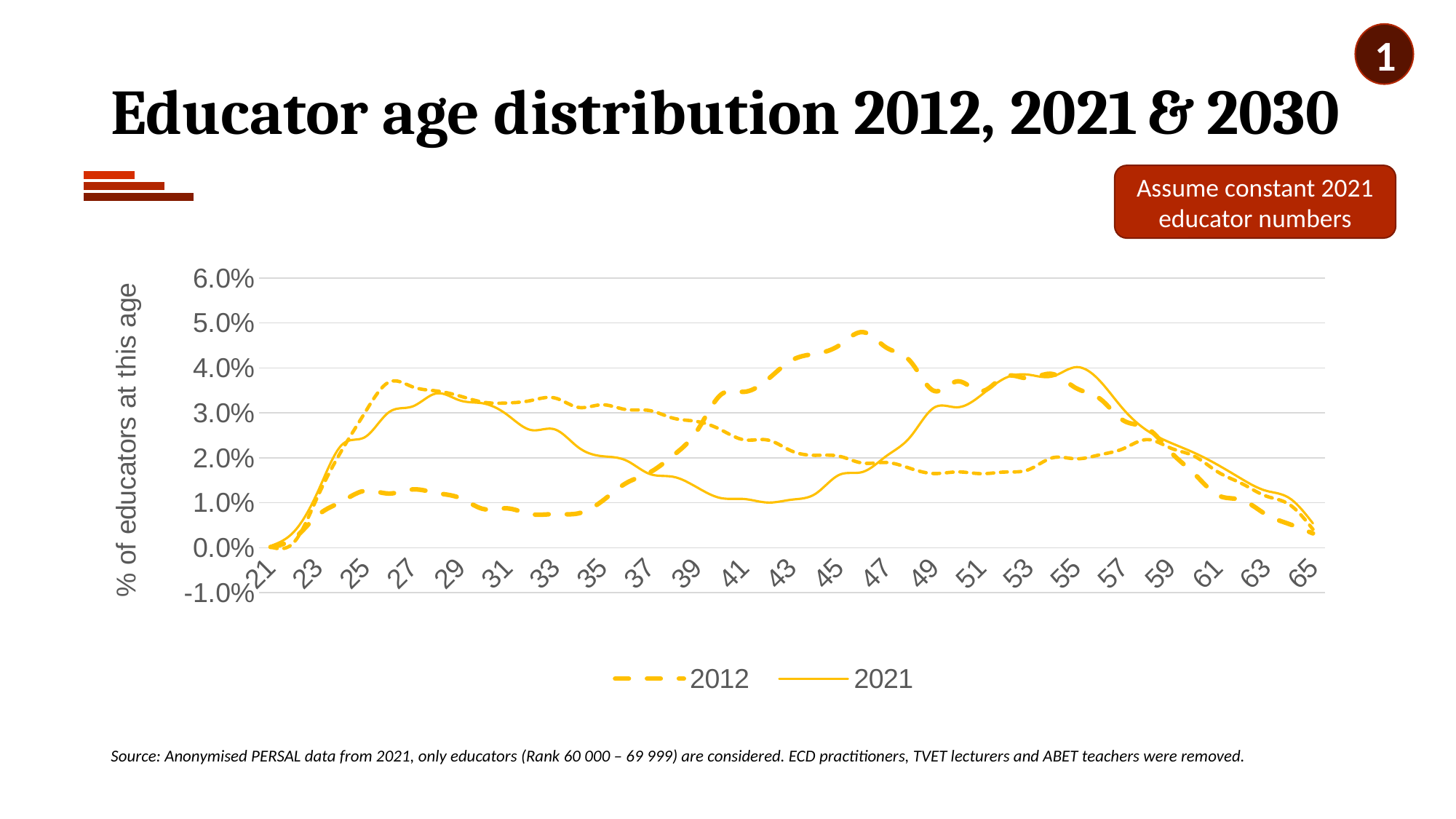
Is the 2021 value at age 41 greater or less than 2.0%? less What is the title of the vertical axis? % of educators at this age At age 45, which series has the larger value, 2012 or 2021? 2012 Is the 2021 value at age 27 greater or less than 2.0%? greater How many series does the chart legend list? 2 Is the 2012 value at age 33 greater or less than 1.0%? less Does the 2021 line rise or fall between age 41 and age 55? rise Which series reaches the higher peak value, 2012 or 2021? 2012 What kind of chart is shown on the slide? line chart